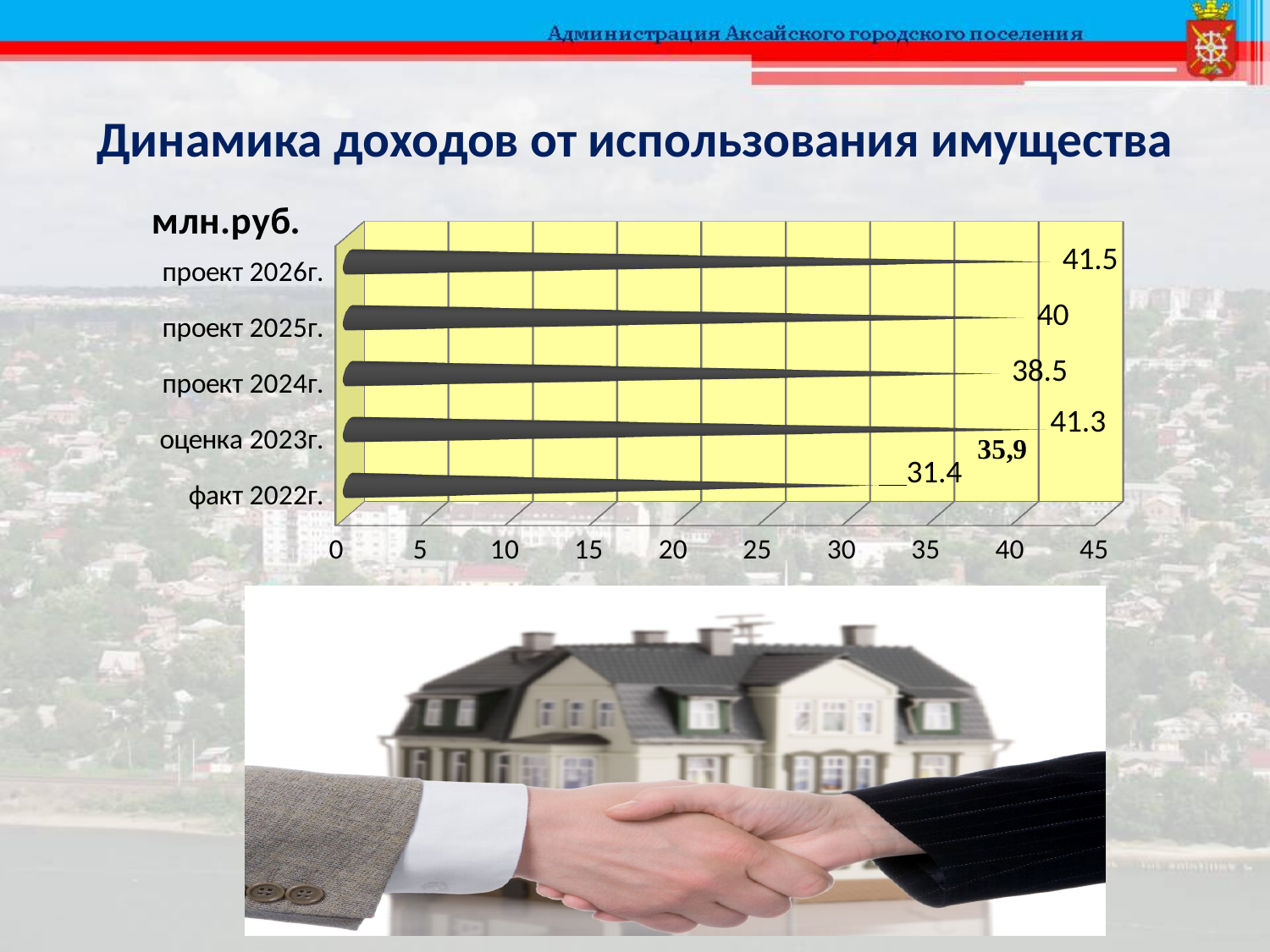
Is the value for факт 2022г. greater or less than 35? less What is the value for проект 2026г.? 41.5 Which is larger, the value for проект 2025г. or проект 2024г.? проект 2025г. What is the value for факт 2022г.? 31.4 What is the difference between the values for проект 2025г. and проект 2024г.? 1.5 Which category has the lowest value? факт 2022г. What kind of chart is shown on the slide? bar chart What is the value for проект 2025г.? 40 What is the title of the chart? Динамика доходов от использования имущества What is the value for проект 2024г.? 38.5 What is the difference between the values for проект 2026г. and факт 2022г.? 10.1 How many categories are shown in the chart? 5